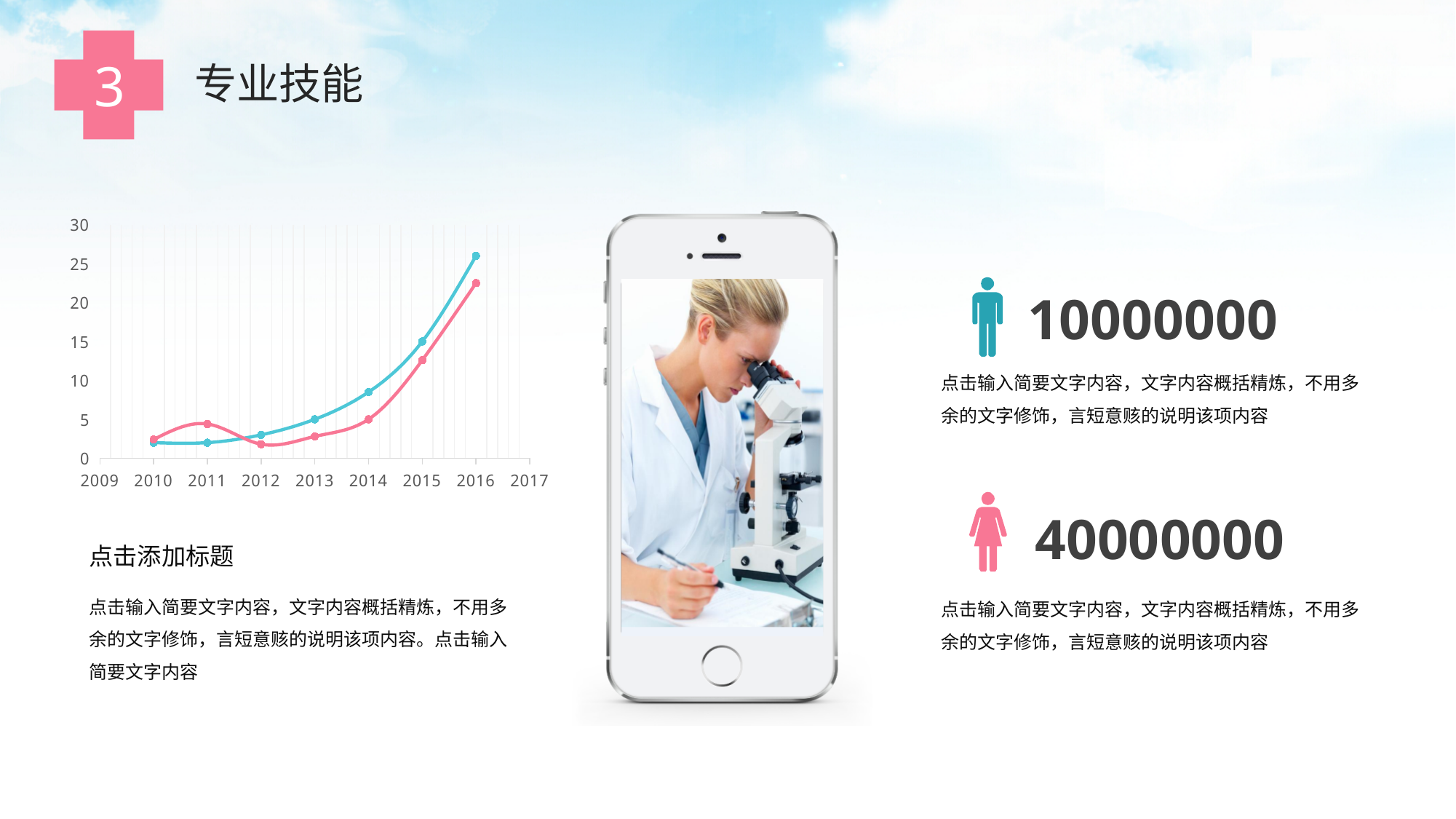
Which year has the highest value on the blue line? 2016 Is the value of the blue line in 2015 greater or less than 10? greater How many lines (series) are plotted in the chart? 2 Does the blue line rise or fall from 2012 to 2016? rise How many data points does the blue line have? 7 What kind of chart is shown on the left of the slide? line chart In 2011, which line has the higher value, blue or pink? pink Is the value of the blue line in 2014 greater or less than 10? less In 2016, which line has the higher value, blue or pink? blue Which year has the highest value on the pink line? 2016 Is the value of the pink line in 2016 greater or less than 20? greater